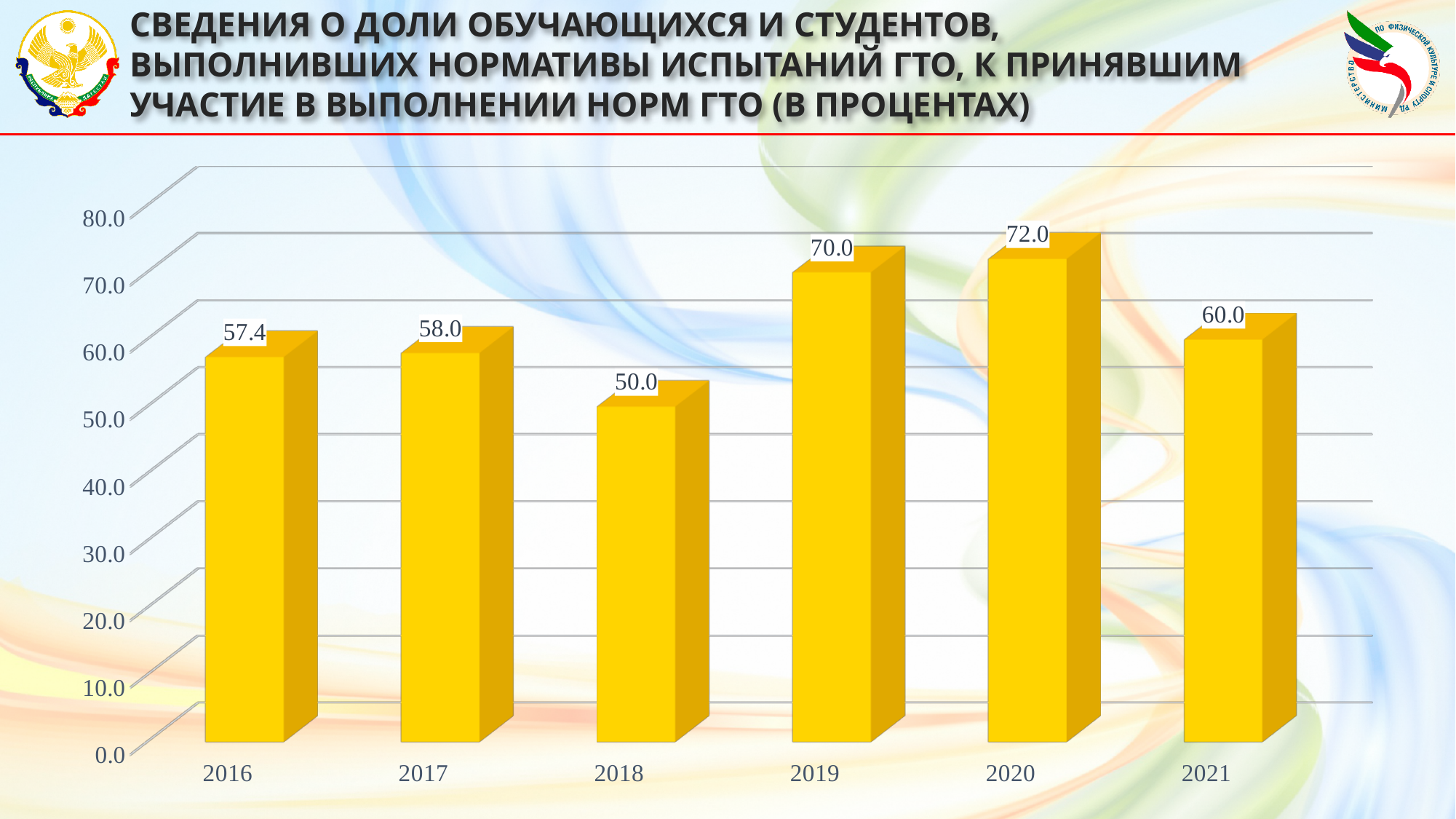
What is the value for 2019? 70.0 Which year has the highest value? 2020 What is the difference between the values for 2020 and 2018? 22.0 Which is larger, the value for 2021 or the value for 2017? 2021 What is the difference between the values for 2019 and 2017? 12.0 What is the value for 2016? 57.4 Do the values rise or fall from 2018 to 2020? rise Is the value for 2018 greater or less than 60.0? less How many years are shown on the x axis? 6 What is the value for 2021? 60.0 What kind of chart is shown on the slide? bar chart Which year has the lowest value? 2018